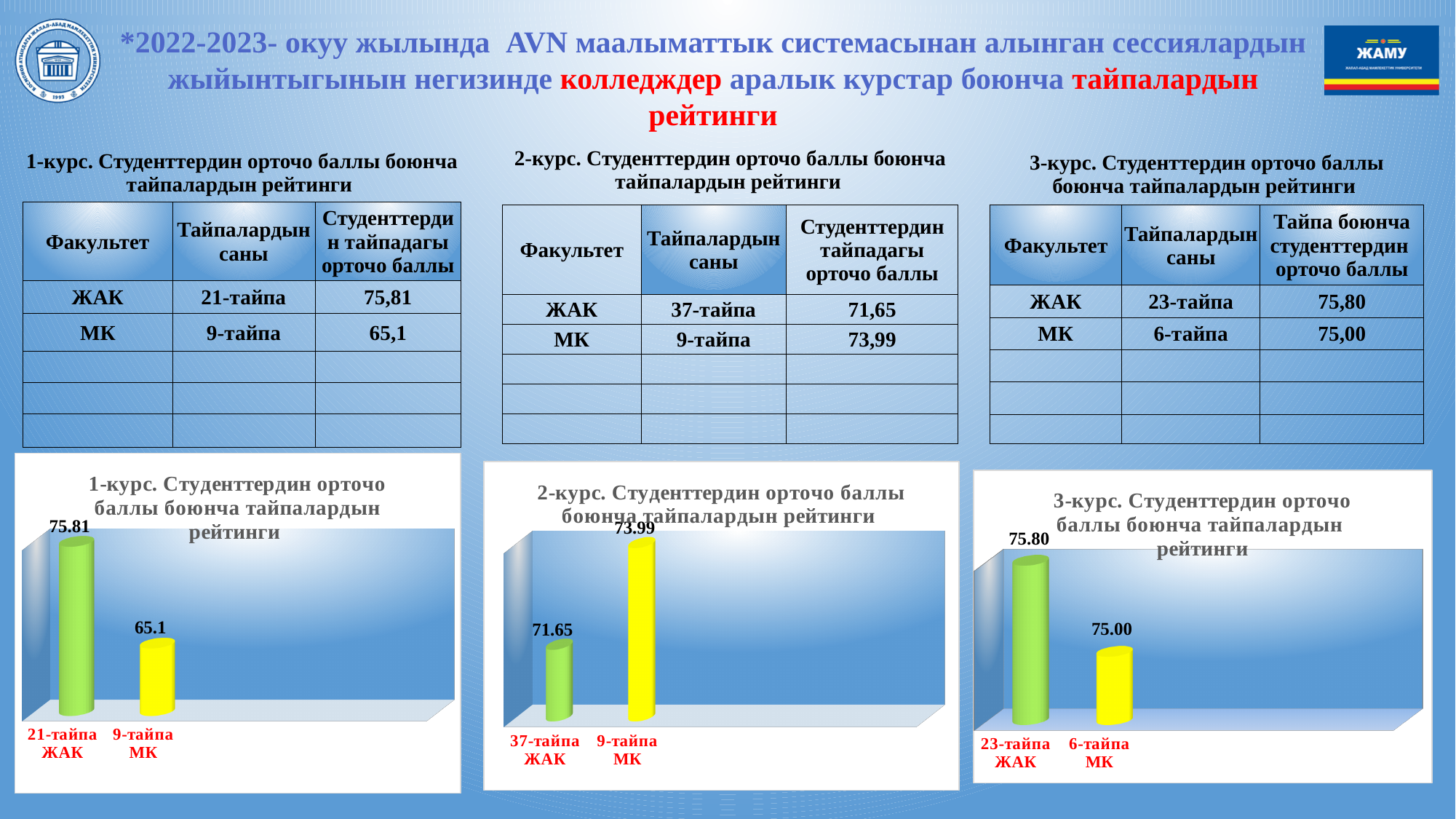
In the left chart (1-курс), what is the difference between the ЖАК and МК values? 10.71 In the middle chart (2-курс), what is the value for МК (9-тайпа)? 73.99 In the middle chart (2-курс), what is the value for ЖАК (37-тайпа)? 71.65 In the left chart (1-курс), what is the value for МК (9-тайпа)? 65.1 In the middle chart (2-курс), what is the difference between the МК and ЖАК values? 2.34 What kind of chart is the left chart (1-курс)? Bar chart In the right chart (3-курс), what is the value for МК (6-тайпа)? 75.00 How many bars are plotted in the right chart (3-курс)? 2 In the left chart (1-курс), which category has the highest value? ЖАК (21-тайпа) In the middle chart (2-курс), which category has the lowest value? ЖАК (37-тайпа) In the left chart (1-курс), what is the value for ЖАК (21-тайпа)? 75.81 In the right chart (3-курс), which is larger, the value for ЖАК or the value for МК? ЖАК